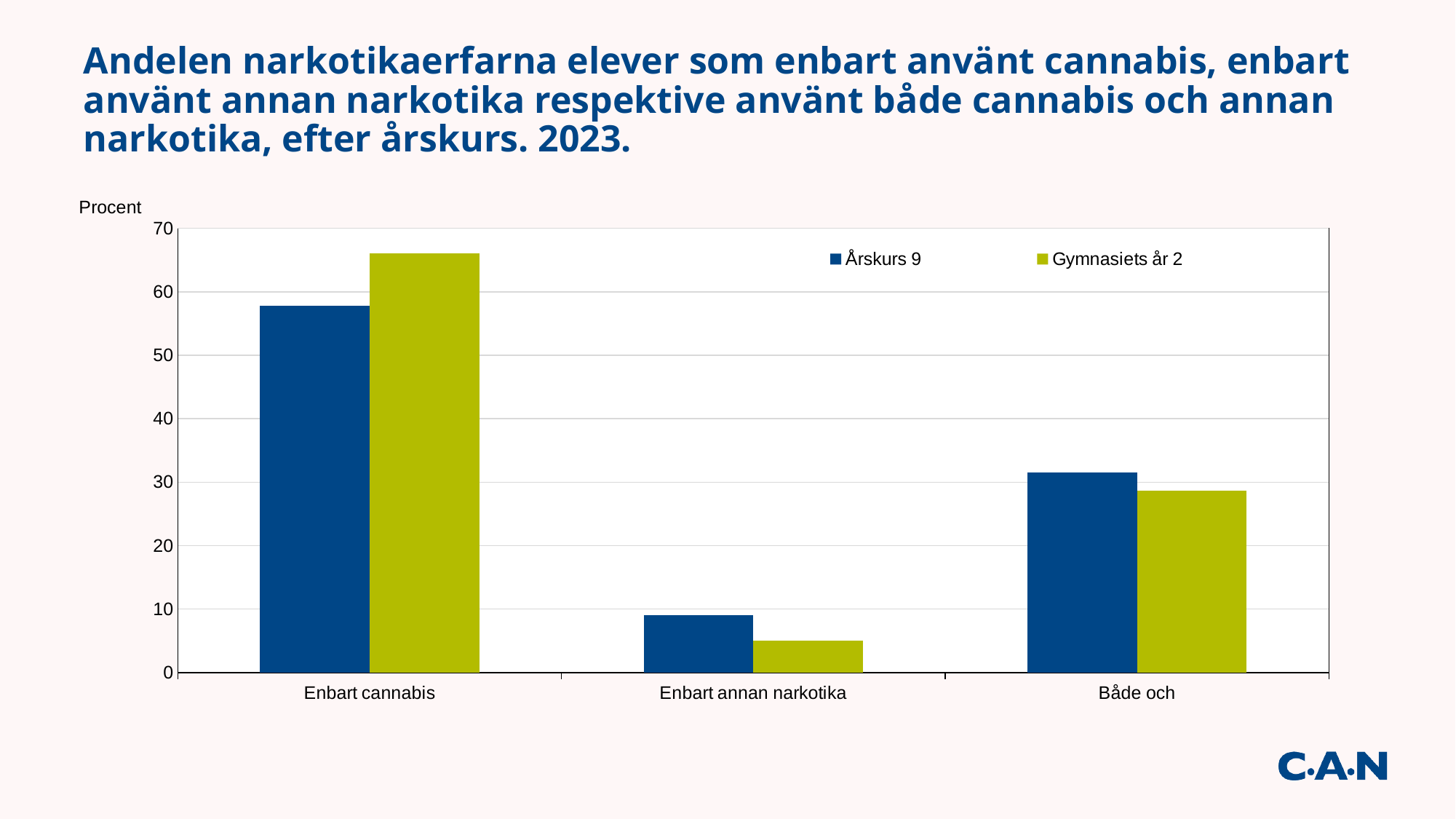
How many categories are shown on the x axis? 3 Which category has the highest value for Gymnasiets år 2? Enbart cannabis For Enbart cannabis, which series has the larger value, Årskurs 9 or Gymnasiets år 2? Gymnasiets år 2 What kind of chart is shown on the slide? bar chart Is the value for Gymnasiets år 2 in Enbart cannabis greater or less than 60? greater How many series does the legend list? 2 Which series is shown in dark blue in the legend? Årskurs 9 Is the value for Årskurs 9 in Både och greater or less than 30? greater What unit is shown on the y axis label? Procent For Enbart annan narkotika, which series has the larger value, Årskurs 9 or Gymnasiets år 2? Årskurs 9 Which category has the lowest value for Årskurs 9? Enbart annan narkotika Is the value for Årskurs 9 in Enbart annan narkotika greater or less than 10? less